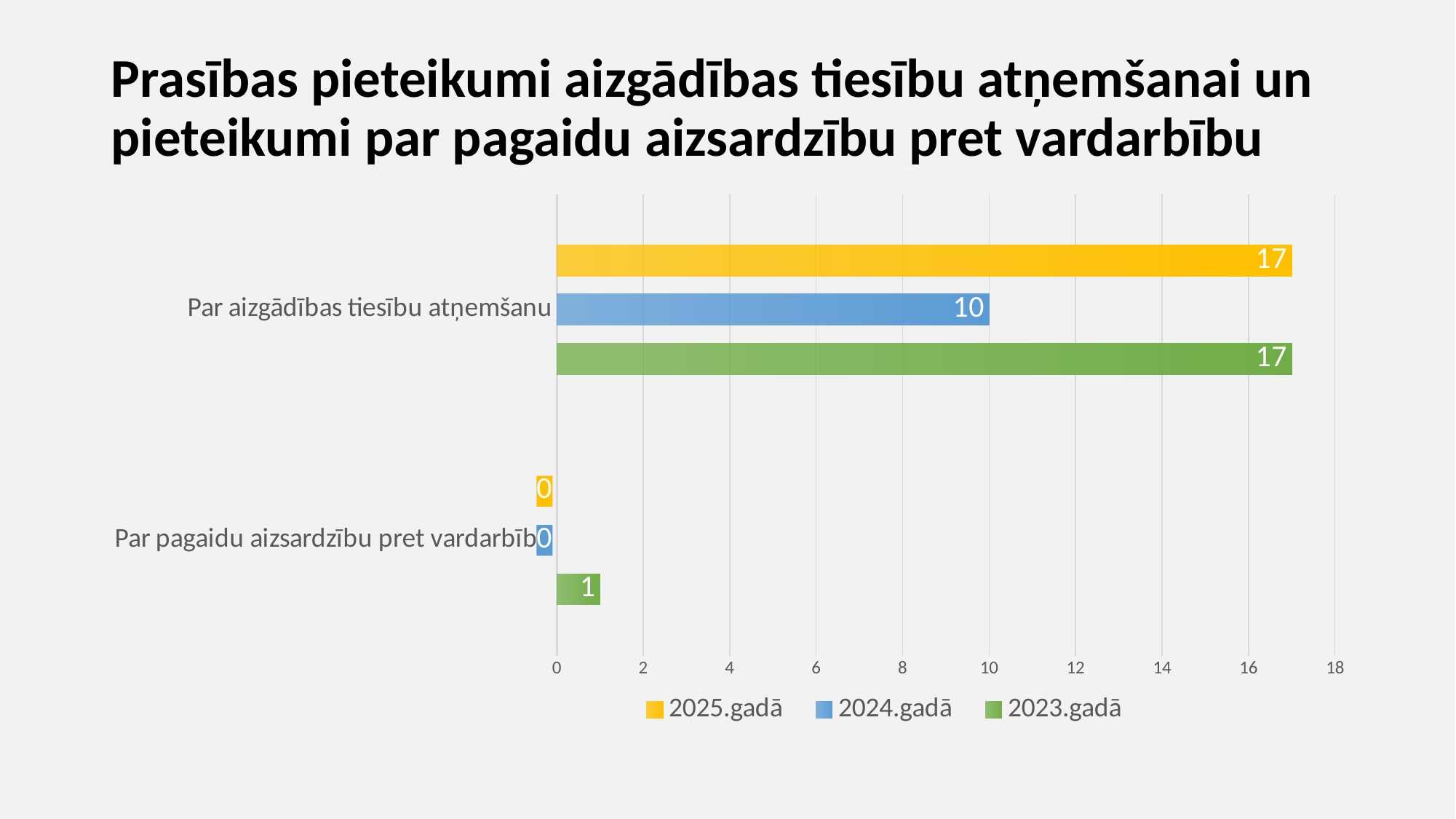
Which is larger for "Par aizgādības tiesību atņemšanu": the 2023.gadā value or the 2024.gadā value? 2023.gadā Is the 2024.gadā value for "Par aizgādības tiesību atņemšanu" greater or less than 8? greater What is the value for 2025.gadā for "Par aizgādības tiesību atņemšanu"? 17 What kind of chart is shown on the slide? Bar chart Which colour represents 2023.gadā in the legend? Green What is the value for 2025.gadā for "Par pagaidu aizsardzību pret vardarbību"? 0 What is the value for 2024.gadā for "Par aizgādības tiesību atņemšanu"? 10 What is the value for 2023.gadā for "Par pagaidu aizsardzību pret vardarbību"? 1 How many categories are shown on the chart? 2 What is the difference between the 2025.gadā and 2024.gadā values for "Par aizgādības tiesību atņemšanu"? 7 How many series does the legend list? 3 Which year has the lowest value for "Par aizgādības tiesību atņemšanu"? 2024.gadā